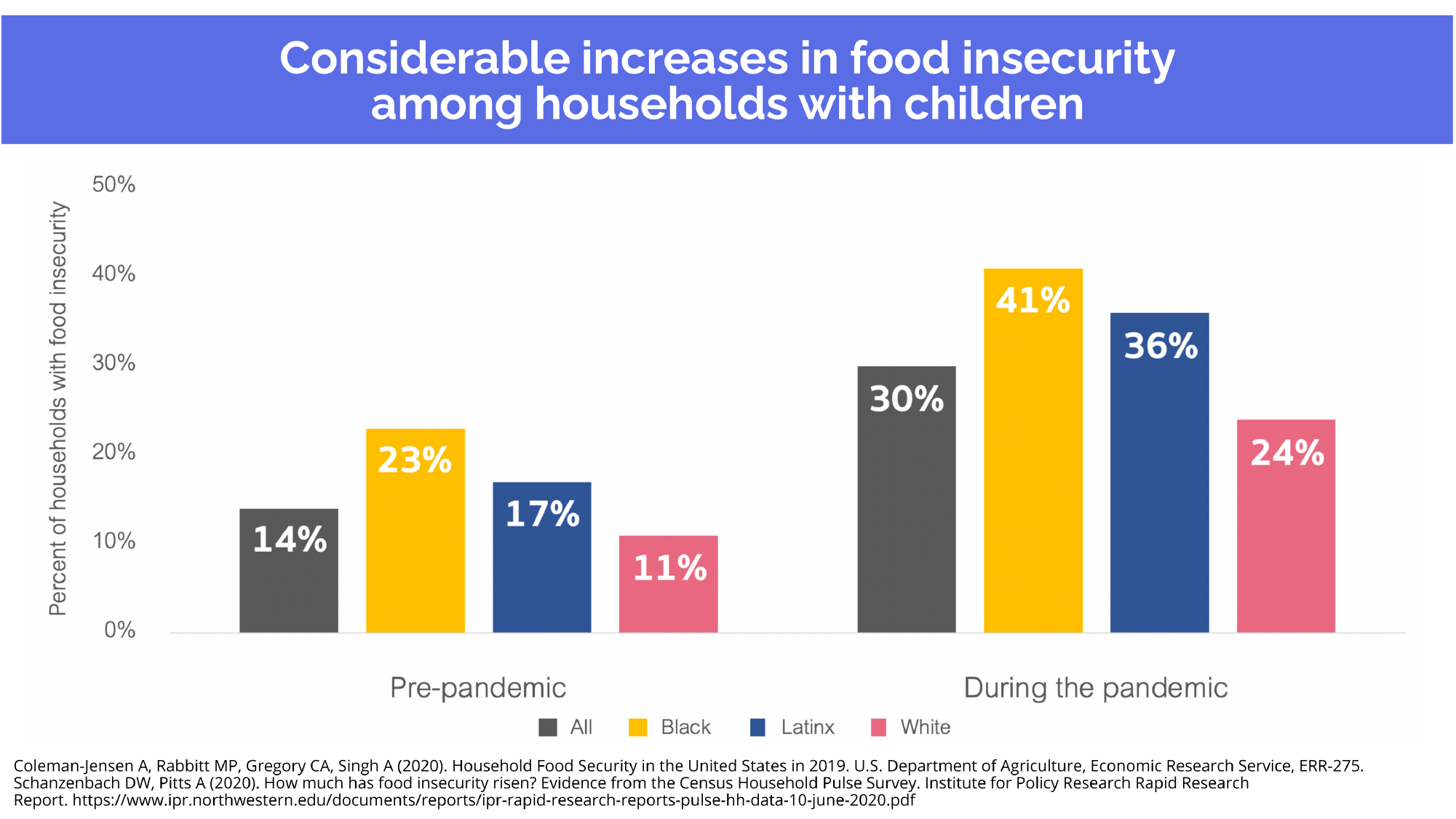
What is the value for All households during the pandemic? 30% What kind of chart is shown on the slide? Bar chart What is the difference between the Black value during the pandemic and pre-pandemic? 18% What is the label of the vertical axis? Percent of households with food insecurity What is the value for Latinx households during the pandemic? 36% Is the value for All households pre-pandemic greater or less than 20%? less What is the value for White households pre-pandemic? 11% Which group has the highest value during the pandemic? Black How many series does the legend list? 4 What is the value for Black households pre-pandemic? 23% Which group has the lowest value pre-pandemic? White Which is larger: the Latinx value pre-pandemic or the White value during the pandemic? White value during the pandemic